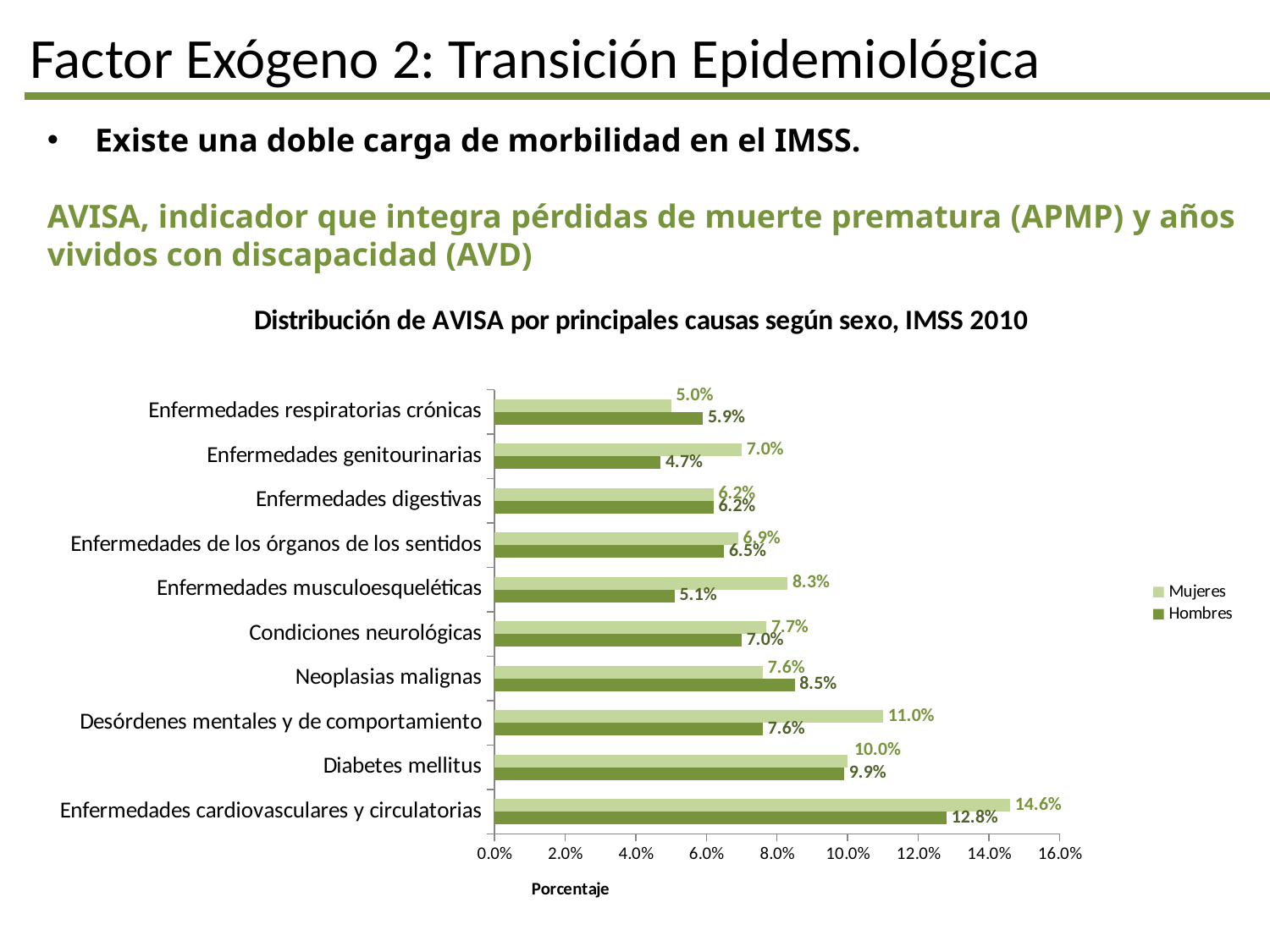
How many categories (causes) are shown in the chart? 10 What is the title of the chart? Distribución de AVISA por principales causas según sexo, IMSS 2010 Which category has the highest Hombres value? Enfermedades cardiovasculares y circulatorias What is the Mujeres value for Enfermedades cardiovasculares y circulatorias? 14.6% For Neoplasias malignas, which is larger, the Mujeres value or the Hombres value? Hombres Which category has the lowest Mujeres value? Enfermedades respiratorias crónicas What is the Mujeres value for Desórdenes mentales y de comportamiento? 11.0% What kind of chart is shown on the slide? Bar chart What is the difference between the Mujeres and Hombres values for Enfermedades musculoesqueléticas? 3.2% What is the Hombres value for Neoplasias malignas? 8.5% What is the Hombres value for Enfermedades genitourinarias? 4.7% How many series does the legend list? 2